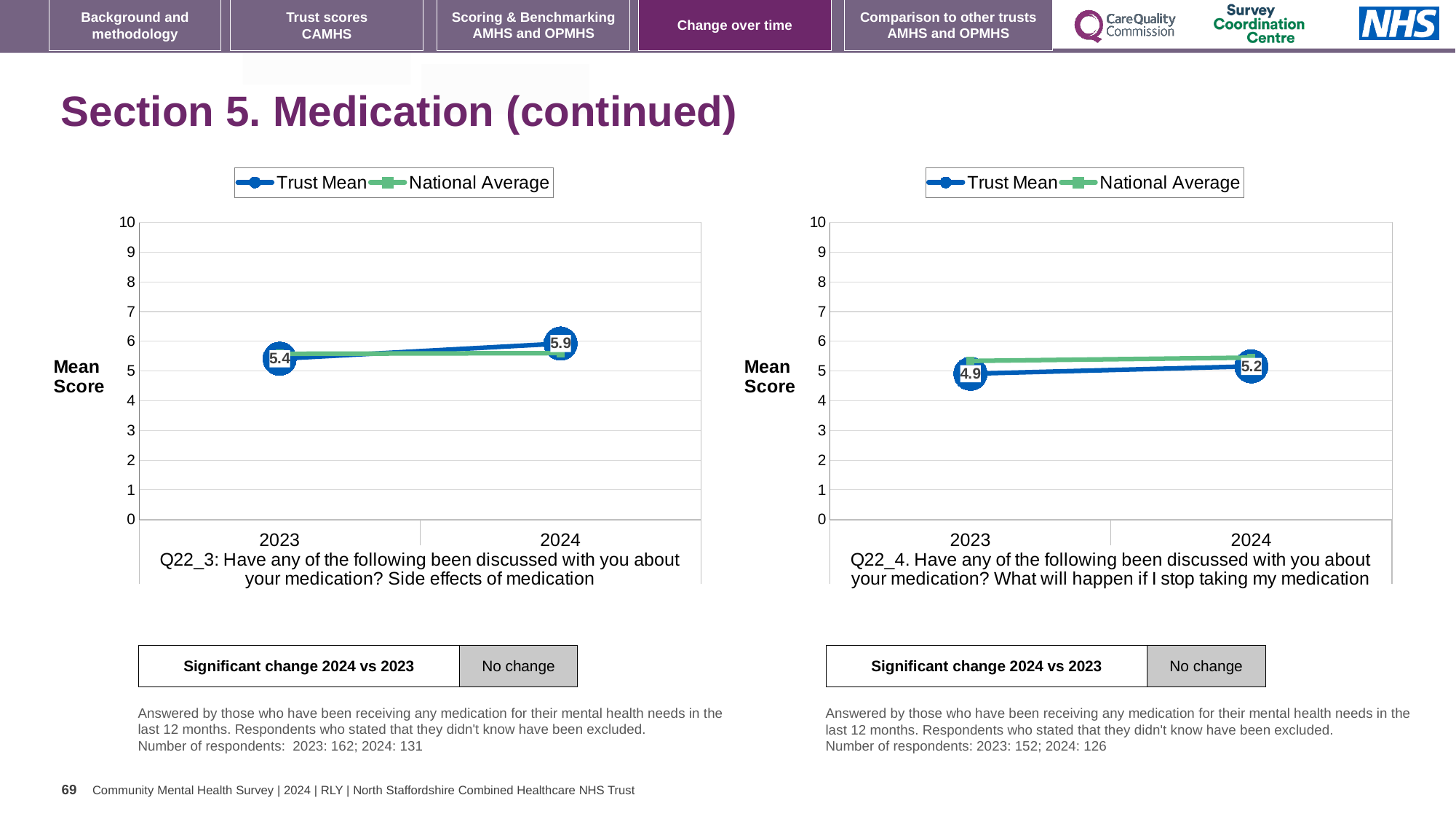
In the Q22_3 chart on the left, what is the Trust Mean for 2024? 5.9 In the Q22_4 chart on the right, is the Trust Mean for 2023 greater or less than 5? less What kind of chart is the Q22_3 chart on the left? line chart In the Q22_4 chart on the right, what is the Trust Mean for 2023? 4.9 In the Q22_3 chart on the left, by how much did the Trust Mean change from 2023 to 2024? 0.5 In the Q22_3 chart on the left, what is the Trust Mean for 2023? 5.4 In the Q22_4 chart on the right, what is the difference between the Trust Mean in 2024 and in 2023? 0.3 In the Q22_4 chart on the right, what is the Trust Mean for 2024? 5.2 How many series does the legend of the Q22_4 chart on the right list? 2 How many years are shown on the x axis of the Q22_3 chart on the left? 2 In the Q22_3 chart on the left, does the Trust Mean rise or fall from 2023 to 2024? rise In the Q22_4 chart on the right, which year has the higher Trust Mean, 2023 or 2024? 2024